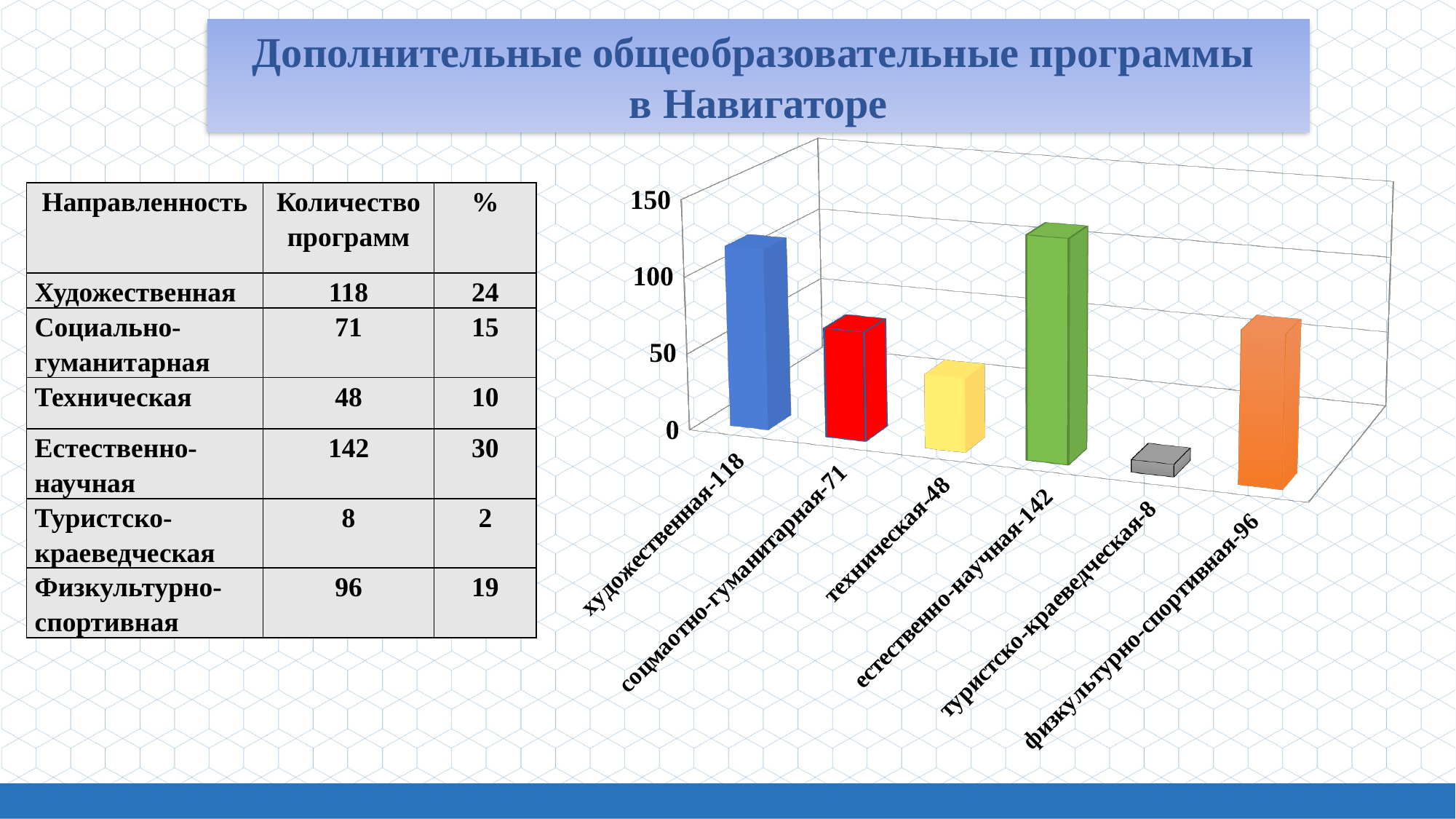
What is the value for физкультурно-спортивная in the chart? 96 What is the value for естественно-научная in the chart? 142 Which category has the highest value in the chart? естественно-научная What is the value for художественная in the chart? 118 What colour is the bar for естественно-научная? green How many categories are plotted in the chart? 6 What type of chart is shown on the slide? bar chart Which category has the lowest value in the chart? туристско-краеведческая Which is larger, the value for художественная or the value for физкультурно-спортивная? художественная What is the difference between the values for естественно-научная and художественная? 24 What is the value for туристско-краеведческая in the chart? 8 Is the value for туристско-краеведческая greater or less than 50? less